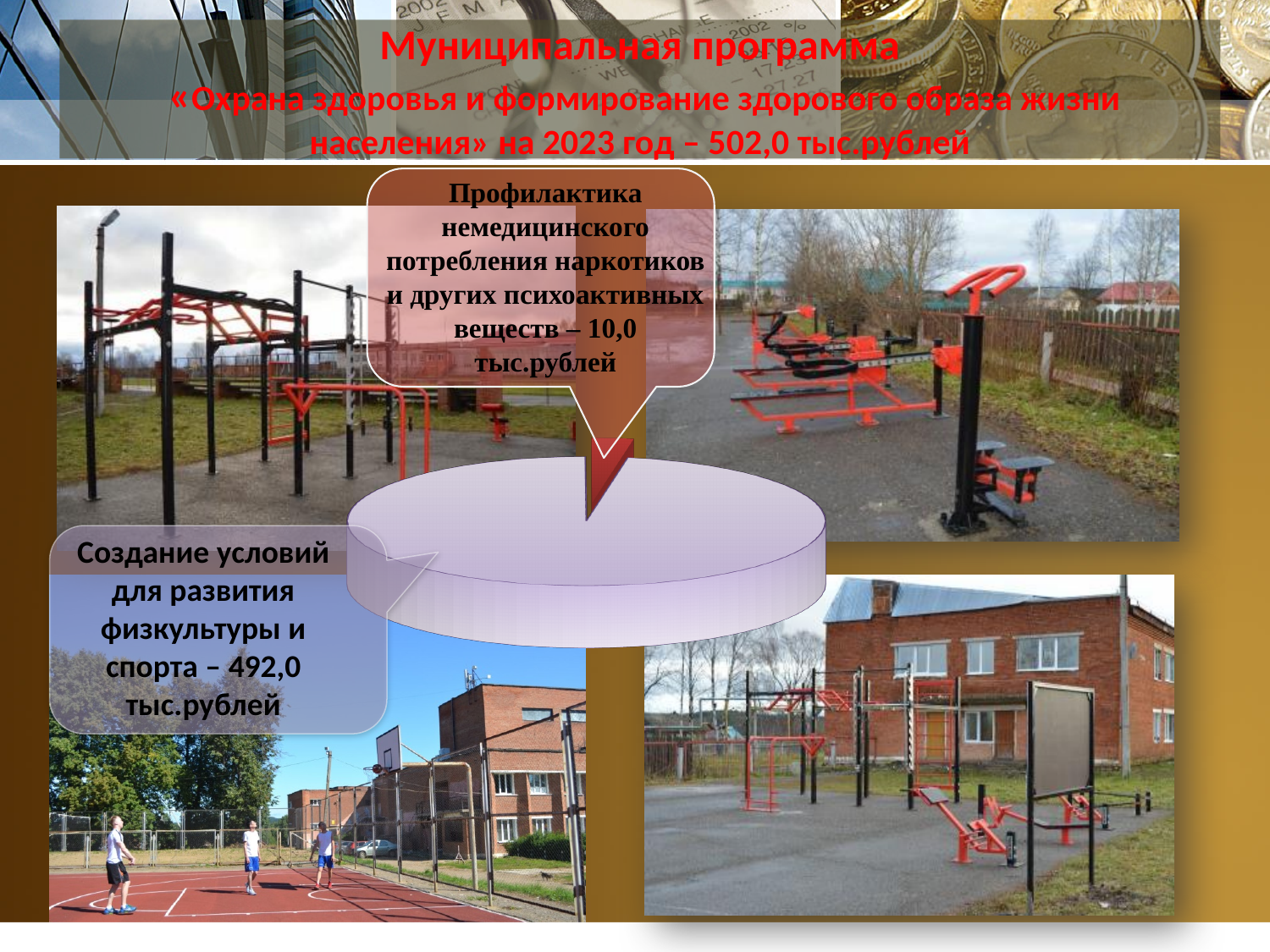
Which slice of the pie chart is the largest? Создание условий для развития физкультуры и спорта What is the name of the municipal programme in the slide title? «Охрана здоровья и формирование здорового образа жизни населения» Which slice of the pie chart is the smallest? Профилактика немедицинского потребления наркотиков и других психоактивных веществ What kind of chart is shown on the slide? Pie chart Which is larger: the value for «Создание условий для развития физкультуры и спорта» or the value for «Профилактика немедицинского потребления наркотиков»? Создание условий для развития физкультуры и спорта What is the value for «Профилактика немедицинского потребления наркотиков и других психоактивных веществ»? 10,0 тыс.рублей For which year is the programme budget shown in the slide title? 2023 How many slices does the pie chart have? 2 What is the difference between the value for «Создание условий для развития физкультуры и спорта» and the value for «Профилактика немедицинского потребления наркотиков»? 482,0 тыс.рублей What is the total of the two values shown in the pie chart? 502,0 тыс.рублей What is the value for «Создание условий для развития физкультуры и спорта»? 492,0 тыс.рублей What share of the pie does «Создание условий для развития физкультуры и спорта» represent? 98%